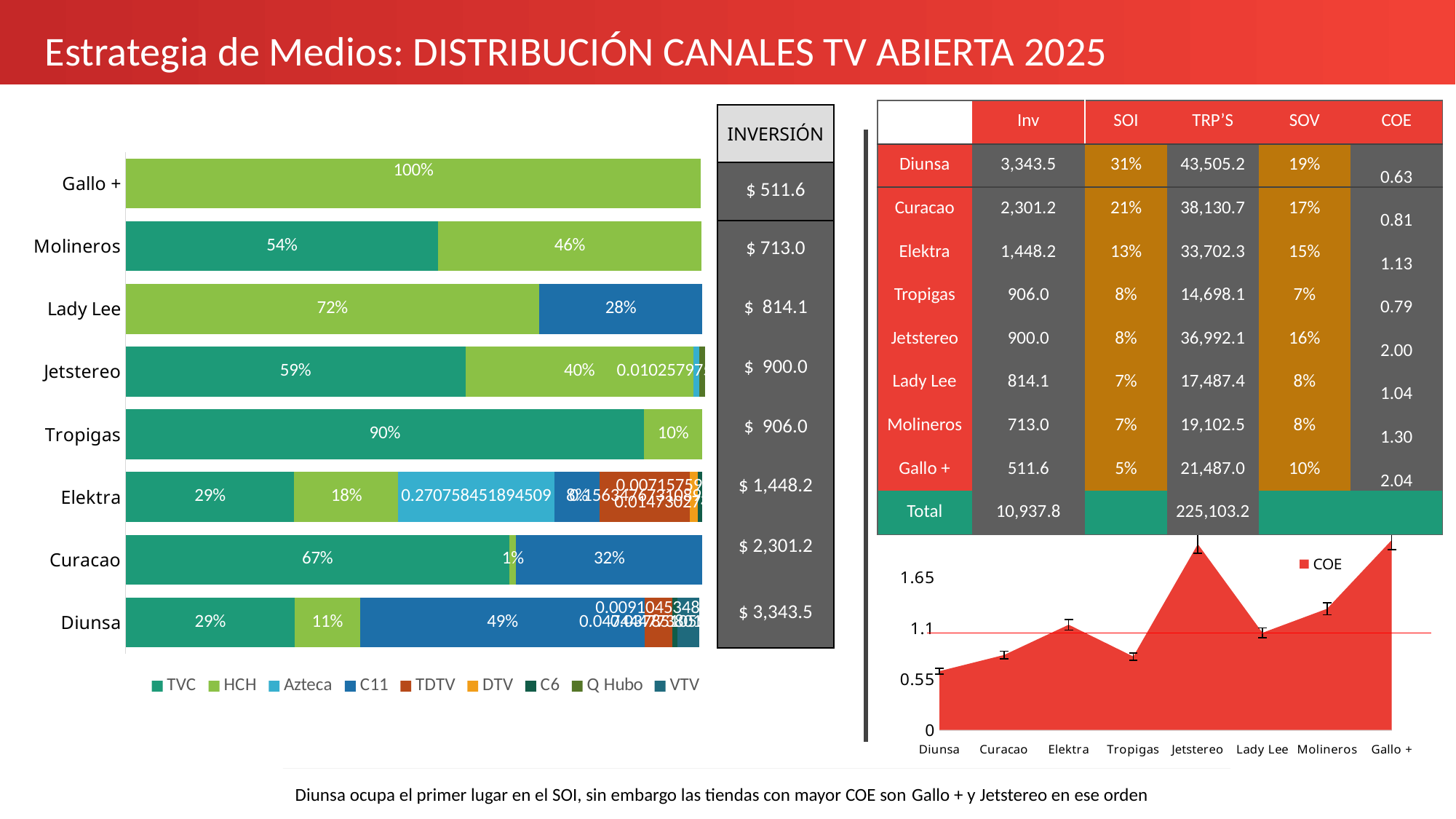
On the stacked bar chart on the left, how many series does the legend list? 9 On the stacked bar chart on the left, how many stores (categories) are shown? 8 On the stacked bar chart on the left, what is the TVC share for Tropigas? 90% On the stacked bar chart on the left, which is larger for Lady Lee: the HCH share or the C11 share? HCH On the stacked bar chart on the left, what is the difference between the TVC share and the HCH share for Molineros? 8% What kind of chart is the COE chart at the bottom right of the slide? Area chart On the COE chart at the bottom right, is the value for Tropigas greater or less than 1.1? less On the stacked bar chart on the left, what share does HCH have for Gallo +? 100% On the stacked bar chart on the left, what is the C11 share for Diunsa? 49% On the COE chart at the bottom right, which store has the lowest COE? Diunsa What kind of chart is the chart on the left of the slide? Stacked bar chart On the COE chart at the bottom right, is the value for Jetstereo greater or less than 1.65? greater